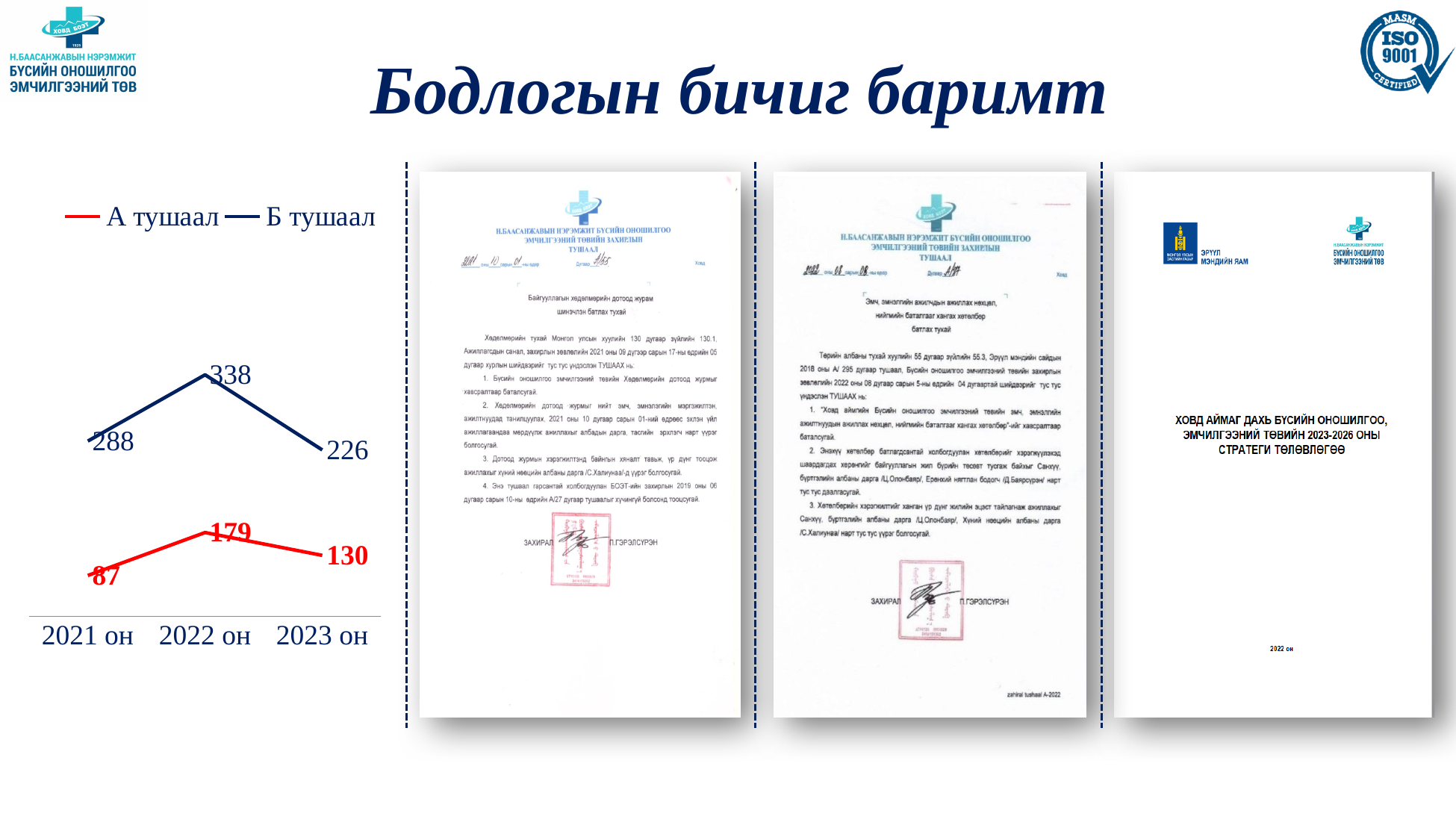
In which year is А тушаал lowest? 2021 он What is the value of А тушаал in 2021 он? 87 How many years are shown on the x axis of the chart? 3 Which is larger in 2023 он, А тушаал or Б тушаал? Б тушаал What type of chart is shown on the slide? line chart What is the difference between Б тушаал and А тушаал in 2022 он? 159 Which colour is used for the А тушаал line? red What is the value of А тушаал in 2023 он? 130 What is the value of Б тушаал in 2022 он? 338 What is the value of Б тушаал in 2021 он? 288 In which year is Б тушаал highest? 2022 он How many series does the chart legend list? 2